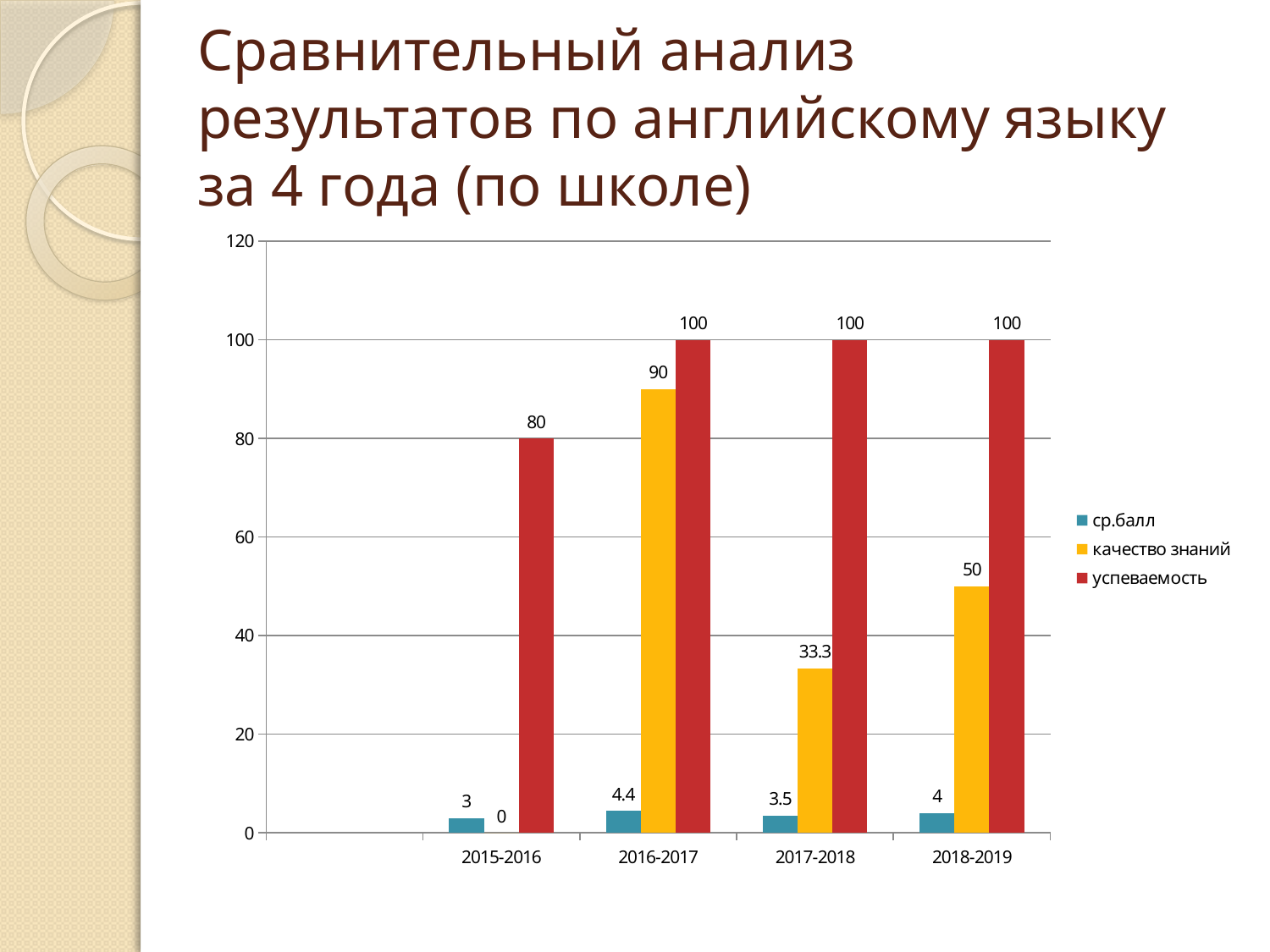
In which year is ср.балл highest? 2016-2017 What is the difference between качество знаний in 2016-2017 and in 2018-2019? 40 What is the value of качество знаний for 2015-2016? 0 How many year categories are shown on the x axis? 4 What is the value of успеваемость for 2015-2016? 80 How many series does the legend list? 3 What type of chart is shown on the slide? bar chart What is the value of качество знаний for 2016-2017? 90 In which year is качество знаний lowest? 2015-2016 Which is larger: качество знаний in 2017-2018 or in 2018-2019? 2018-2019 What is the value of ср.балл for 2017-2018? 3.5 Which series is shown in red in the legend? успеваемость